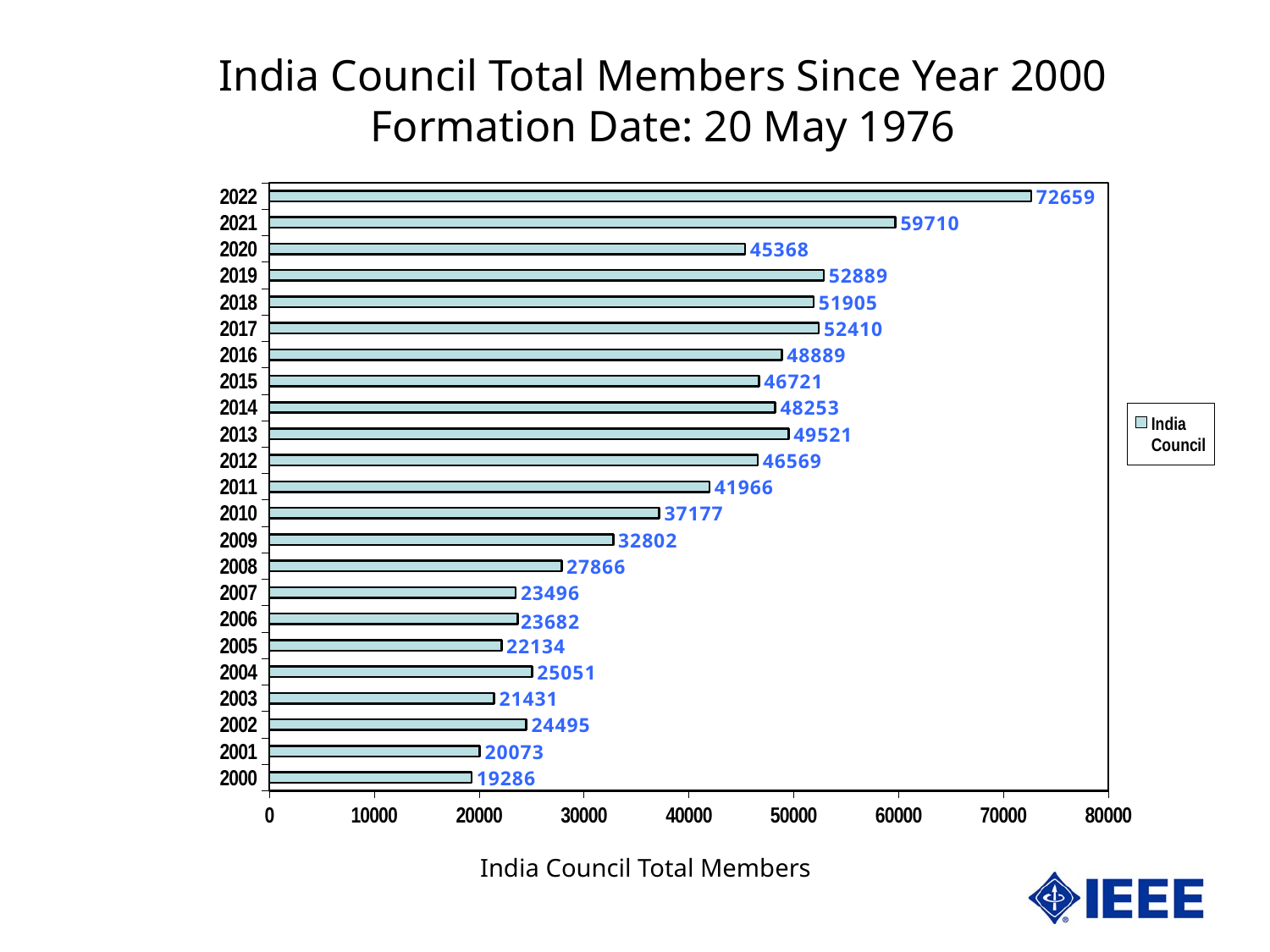
What is the India Council total membership for 2022? 72659 What is the India Council total membership for 2010? 37177 What is the India Council total membership for 2000? 19286 How many years are shown on the chart? 23 What is the difference in total members between 2022 and 2021? 12949 How many series does the legend list? 1 Is the value for 2021 greater or less than 50000? greater What kind of chart is shown on the slide? Bar chart What is the name of the series shown in the legend? India Council Which year has the lowest India Council total membership? 2000 Which year has the highest India Council total membership? 2022 Which year had more members, 2019 or 2020? 2019